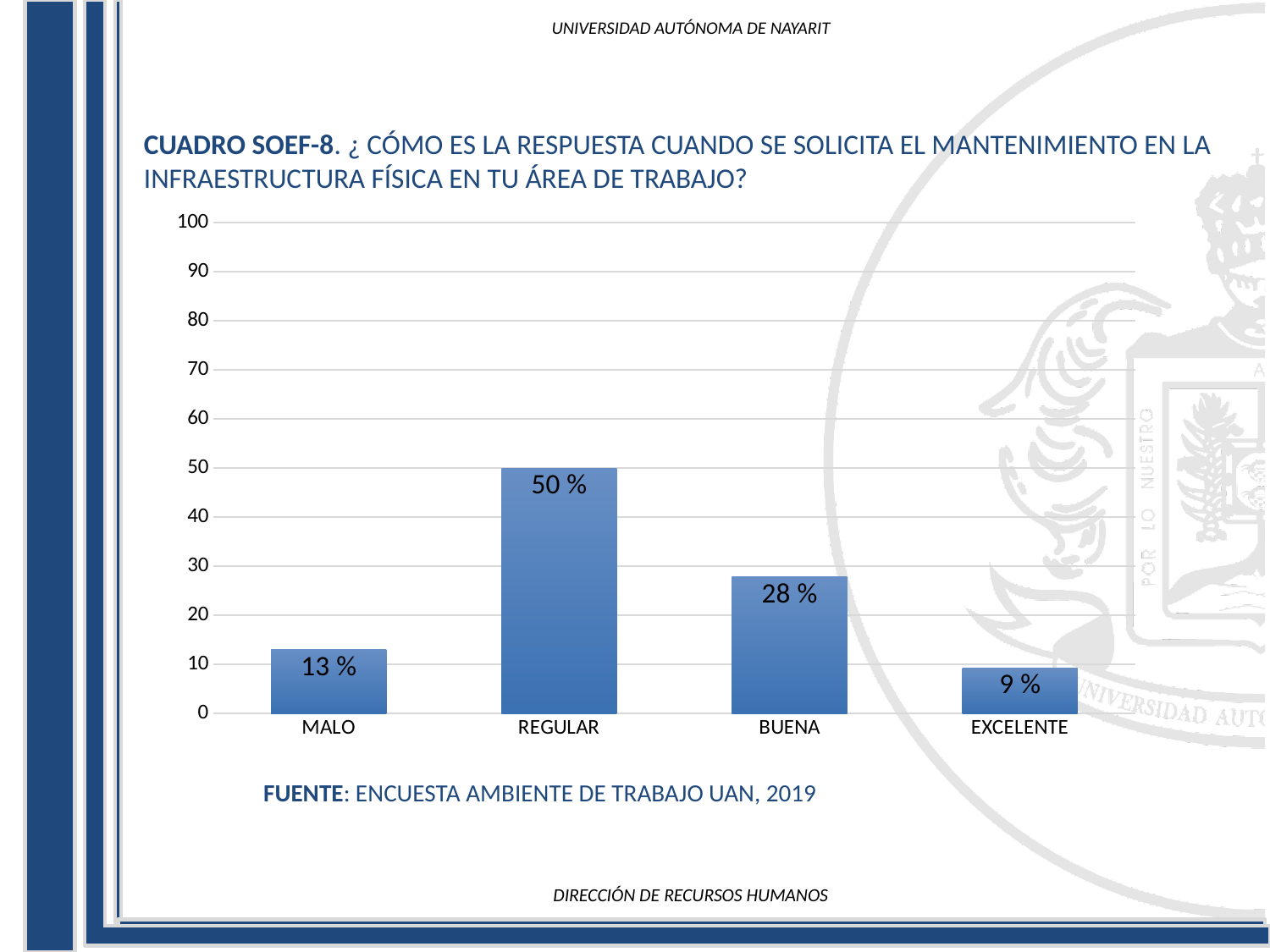
Is the value for BUENA greater or less than 30? less How many categories are shown on the x axis? 4 What source is cited below the chart? ENCUESTA AMBIENTE DE TRABAJO UAN, 2019 What is the value for MALO? 13 % What is the value for REGULAR? 50 % What is the difference between the values for REGULAR and BUENA? 22 % What kind of chart is shown on the slide? bar chart What is the value for EXCELENTE? 9 % Which category has the lowest value? EXCELENTE Which category has the highest value? REGULAR What is the highest value shown on the y axis? 100 Which is larger, the value for MALO or the value for BUENA? BUENA